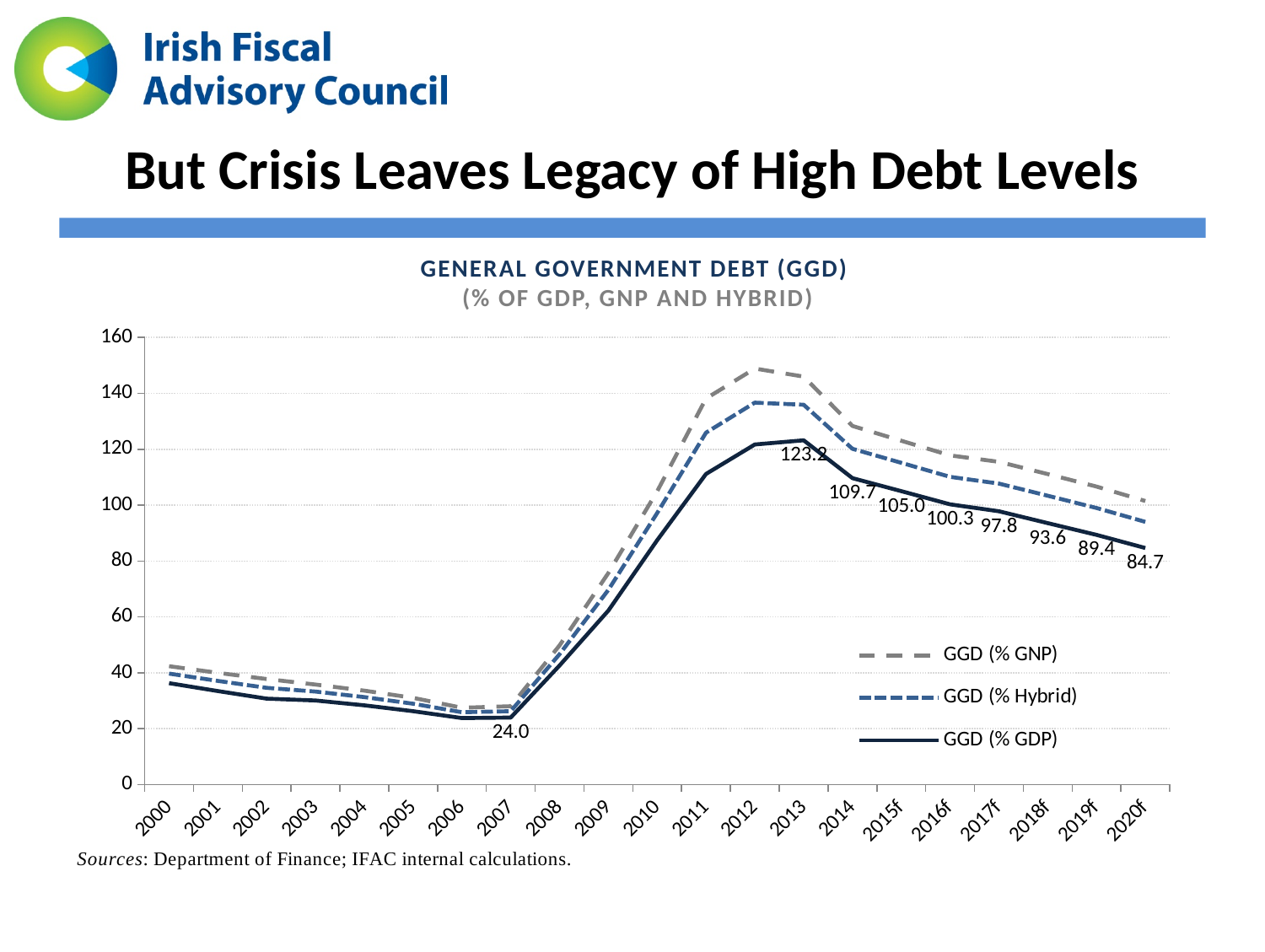
What is the value of GGD (% GDP) in 2007? 24.0 What is the difference between the GGD (% GDP) values in 2013 and 2020f? 38.5 What is the difference between the GGD (% GDP) values in 2013 and 2014? 13.5 Which year has the highest labelled value for GGD (% GDP)? 2013 What is the value of GGD (% GDP) in 2020f? 84.7 Does GGD (% GDP) rise or fall from 2013 to 2020f? Fall What type of chart is shown on the slide? Line chart How many years are shown on the x axis? 21 How many series does the legend list? 3 Is the value of GGD (% GNP) in 2012 greater or less than 140? greater What is the value of GGD (% GDP) in 2013? 123.2 What is the value of GGD (% GDP) in 2016f? 100.3